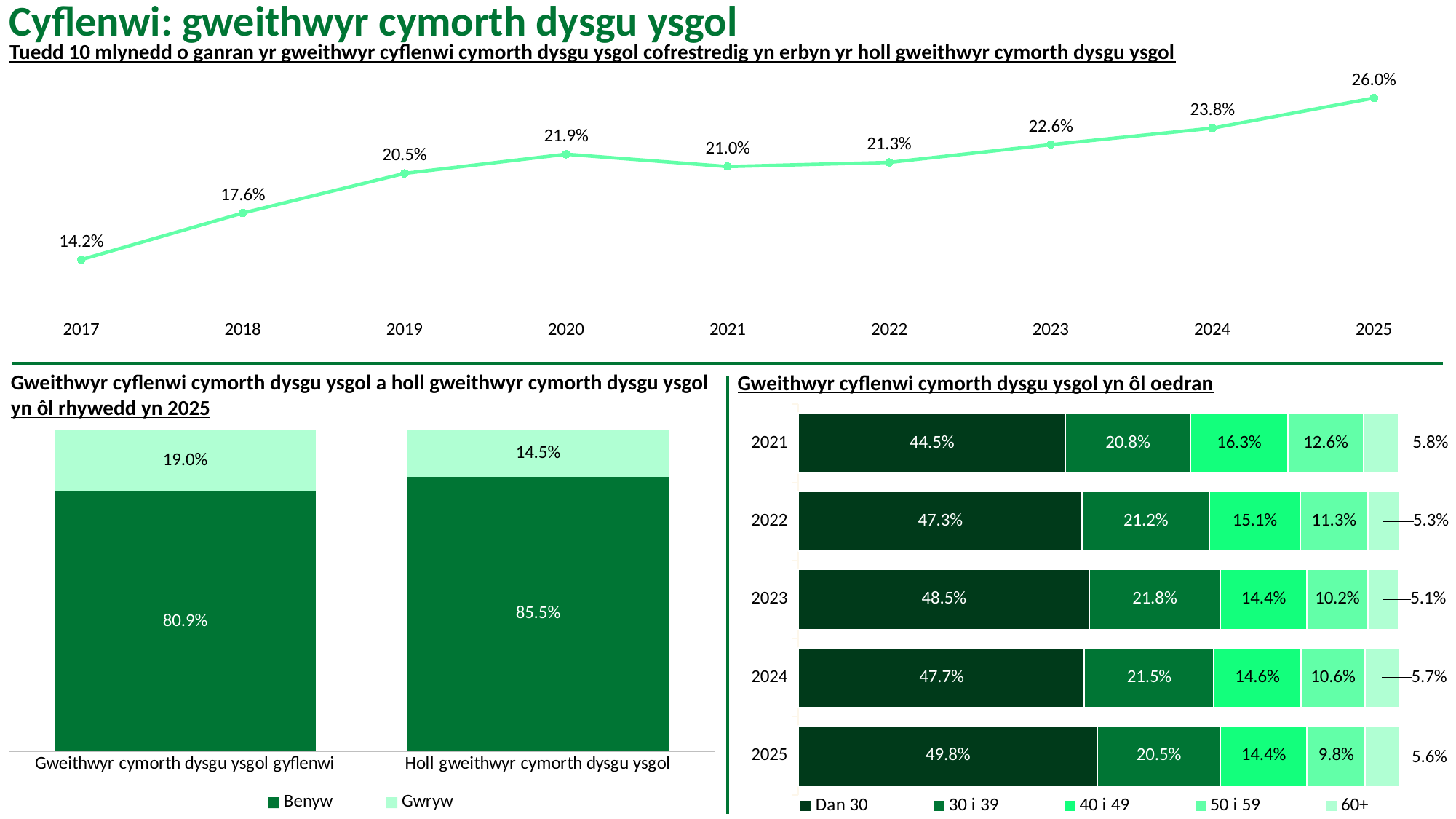
In the top line chart, what is the value for 2020? 21.9% In the bottom-left chart (by gender in 2025), which bar has the larger Benyw value: Gweithwyr cymorth dysgu ysgol gyflenwi or Holl gweithwyr cymorth dysgu ysgol? Holl gweithwyr cymorth dysgu ysgol In the bottom-right chart (by age), what is the Dan 30 value for 2025? 49.8% How many data points are plotted in the top line chart? 9 In the top line chart, what is the difference between the 2025 value and the 2017 value? 11.8 percentage points In the top line chart, do the values generally rise or fall from 2017 to 2025? rise In the bottom-right chart (by age), what is the 60+ value for 2022? 5.3% What kind of chart is the top chart on the slide? line chart In the top line chart, which year has the lowest value? 2017 In the top line chart, which year has the highest value? 2025 How many series does the legend of the bottom-right chart (by age) list? 5 In the bottom-left chart (by gender in 2025), what is the Gwryw value for Gweithwyr cymorth dysgu ysgol gyflenwi? 19.0%